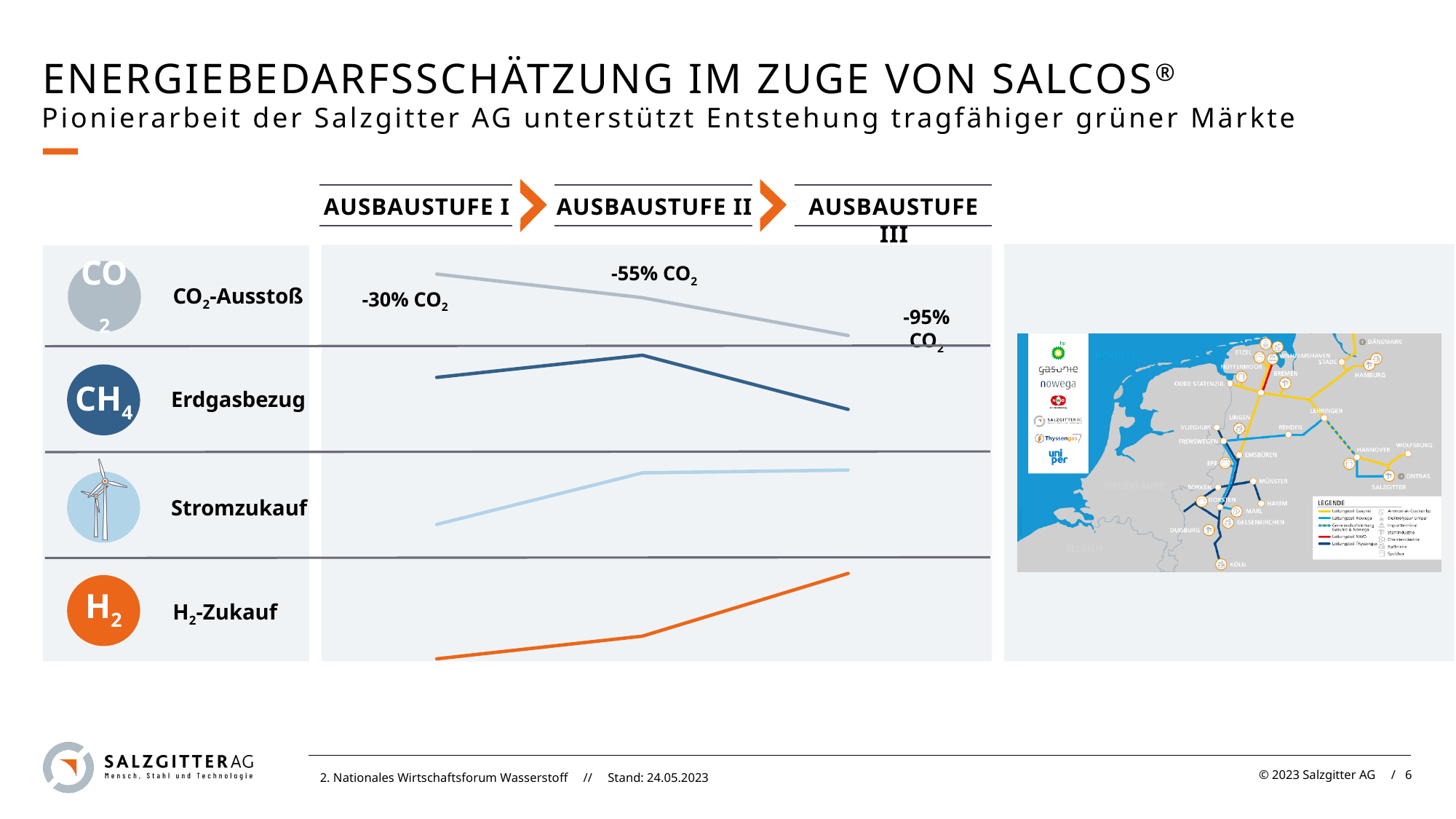
What kind of chart is used to show the development of each quantity across the Ausbaustufen? Line chart How many Ausbaustufen (expansion stages) are shown along the x axis of the charts? 3 Does the CO2-Ausstoß line rise or fall from Ausbaustufe I to Ausbaustufe III? Falls What colour is the H2-Zukauf line? Orange What CO2 reduction is labelled for Ausbaustufe I in the CO2-Ausstoß row? -30% CO2 Does the H2-Zukauf line rise or fall from Ausbaustufe I to Ausbaustufe III? Rises Does the Erdgasbezug line rise or fall from Ausbaustufe II to Ausbaustufe III? Falls In which Ausbaustufe does the Erdgasbezug line reach its highest point? Ausbaustufe II What CO2 reduction is labelled for Ausbaustufe III in the CO2-Ausstoß row? -95% CO2 What CO2 reduction is labelled for Ausbaustufe II in the CO2-Ausstoß row? -55% CO2 How many rows (quantities) are plotted as lines on the slide? 4